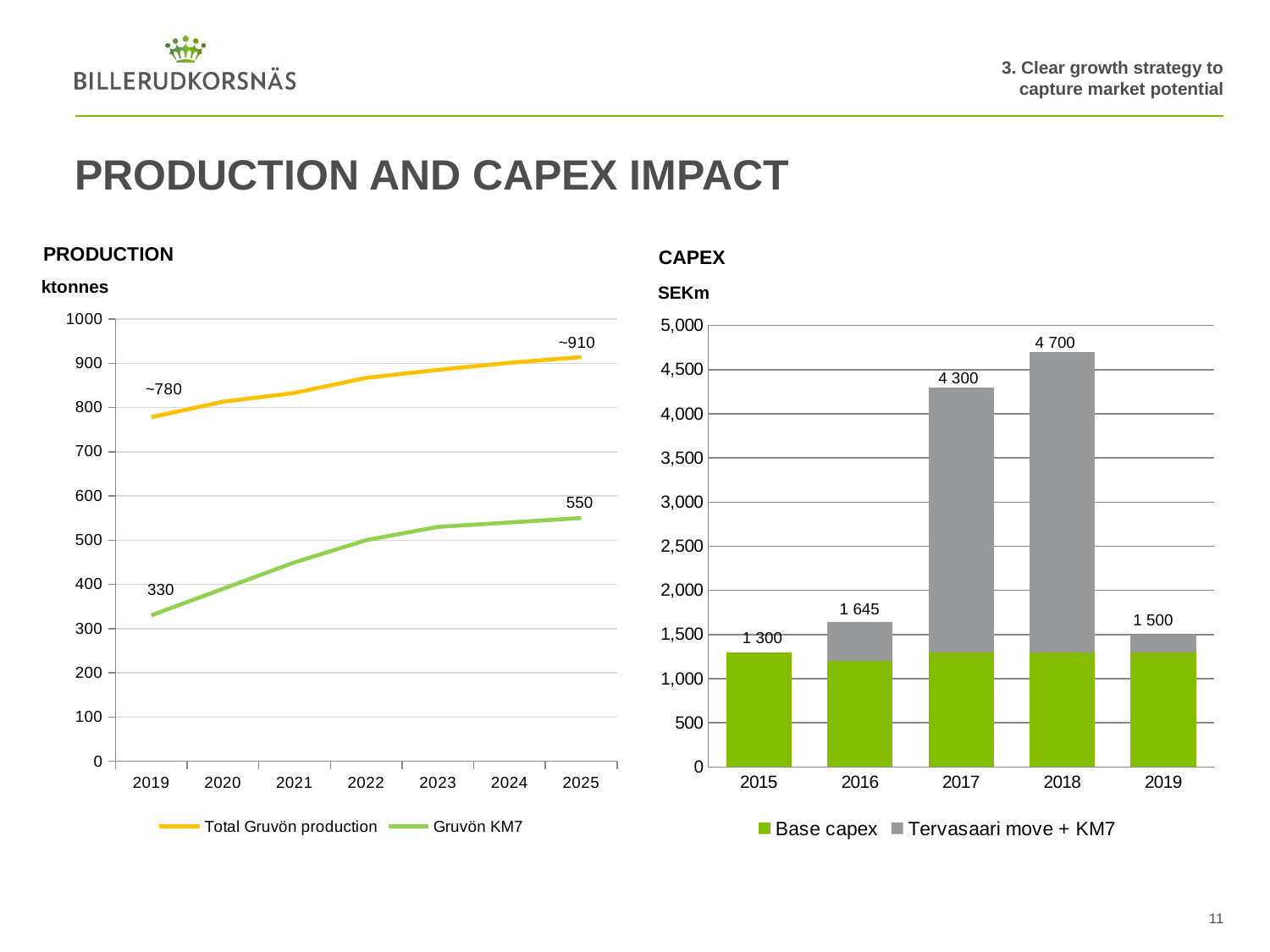
In the PRODUCTION chart, what is the Gruvön KM7 value in 2019? 330 How many series does the legend of the PRODUCTION chart list? 2 In the CAPEX chart, which year has the highest total capex? 2018 In the CAPEX chart, what is the difference between the total capex in 2017 and in 2016? 2 655 In the PRODUCTION chart, what is the Gruvön KM7 value in 2025? 550 What kind of chart is the CAPEX chart? bar chart What kind of chart is the PRODUCTION chart? line chart In the CAPEX chart, what is the total capex for 2018? 4 700 In the PRODUCTION chart, is the Total Gruvön production value for 2022 greater or less than 800? greater In the PRODUCTION chart, by how much does Gruvön KM7 increase from 2019 to 2025? 220 In the CAPEX chart, which year has the lowest total capex? 2015 In the PRODUCTION chart, does Gruvön KM7 rise or fall from 2019 to 2025? rise